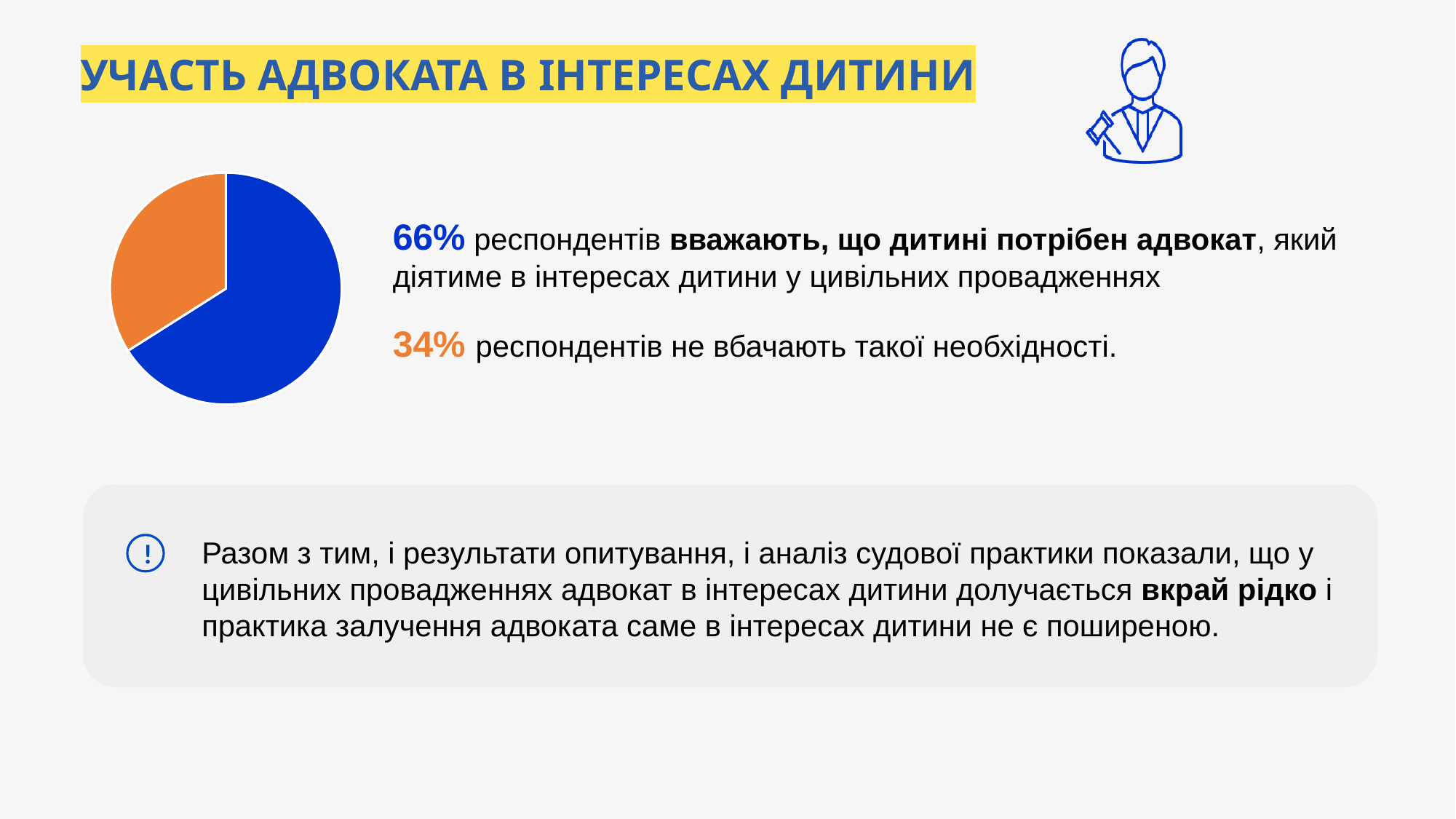
Which slice of the pie chart is the smallest? 34% (respondents who do not see such a need) How many slices does the pie chart have? 2 What is the difference in percentage points between respondents who believe a child needs a lawyer and those who do not? 32 percentage points Is the share of respondents who believe a child needs a lawyer greater or less than 50%? greater Which slice of the pie chart is the largest? 66% (respondents who believe a child needs a lawyer) What kind of chart is shown on the slide? pie chart Which is larger: the share of respondents who believe a child needs a lawyer or the share who do not see such a need? the share who believe a child needs a lawyer (66%) What share of respondents believe a child needs a lawyer acting in the child's interests in civil proceedings? 66% What colour is the slice representing the 34% of respondents who do not see a need for a lawyer? orange What colour is the slice representing the 66% of respondents who believe a child needs a lawyer? blue What share of respondents do not see a need for a lawyer acting in the child's interests? 34% What is the total of the two pie chart slices? 100%